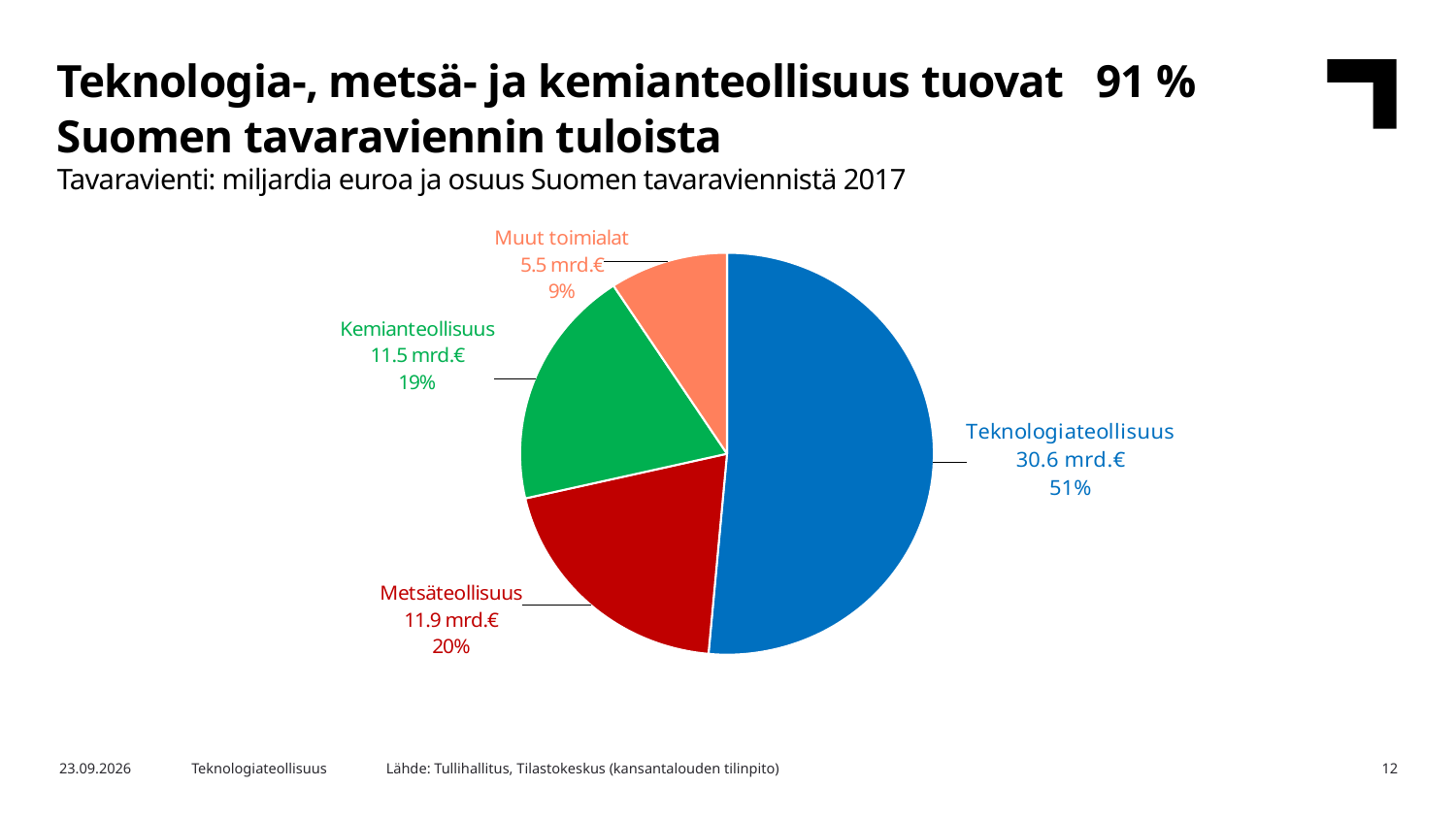
What share of the pie does Teknologiateollisuus represent? 51% What is the value for Metsäteollisuus in the pie chart? 11.9 mrd.€ What is the value for Kemianteollisuus in the pie chart? 11.5 mrd.€ What is the difference in value between Teknologiateollisuus and Metsäteollisuus? 18.7 mrd.€ What is the value for Muut toimialat in the pie chart? 5.5 mrd.€ Which category has the largest slice in the pie chart? Teknologiateollisuus What share of the pie does Muut toimialat represent? 9% Which colour is used for the Kemianteollisuus slice? Green What is the value for Teknologiateollisuus in the pie chart? 30.6 mrd.€ How many slices does the pie chart have? 4 Which category has the smallest slice in the pie chart? Muut toimialat What type of chart is shown on the slide? Pie chart